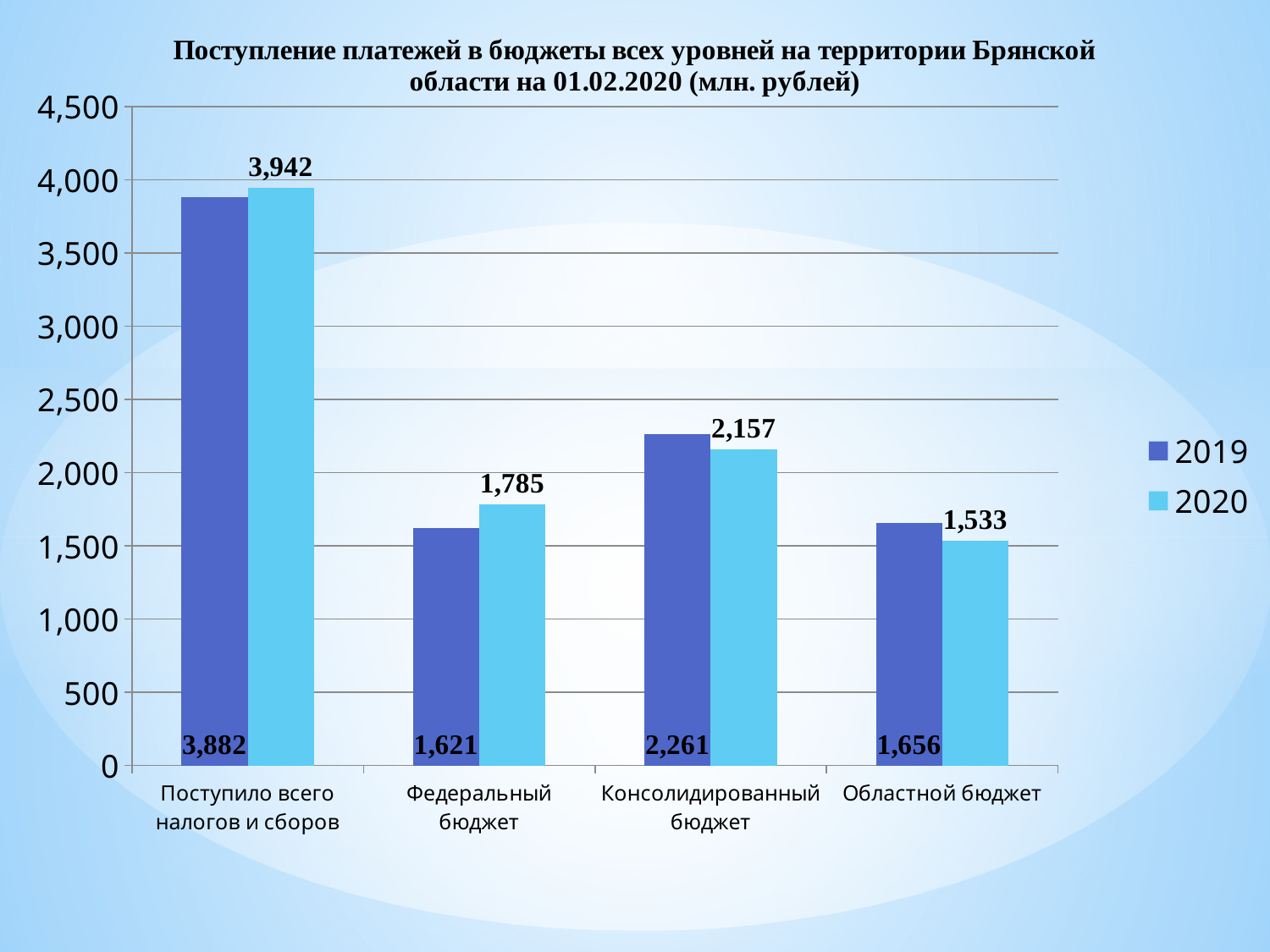
Which category has the highest 2019 value? Поступило всего налогов и сборов Which category has the lowest 2020 value? Областной бюджет How many series does the legend list? 2 Which series is shown in light blue in the legend? 2020 What is the 2019 value for Федеральный бюджет? 1,621 For Консолидированный бюджет, which is larger: the 2019 value or the 2020 value? 2019 What is the 2020 value for Поступило всего налогов и сборов? 3,942 How many categories are shown on the x axis? 4 What kind of chart is shown on the slide? bar chart What is the 2020 value for Консолидированный бюджет? 2,157 What is the difference between the 2020 and 2019 values for Федеральный бюджет? 164 What is the 2019 value for Областной бюджет? 1,656